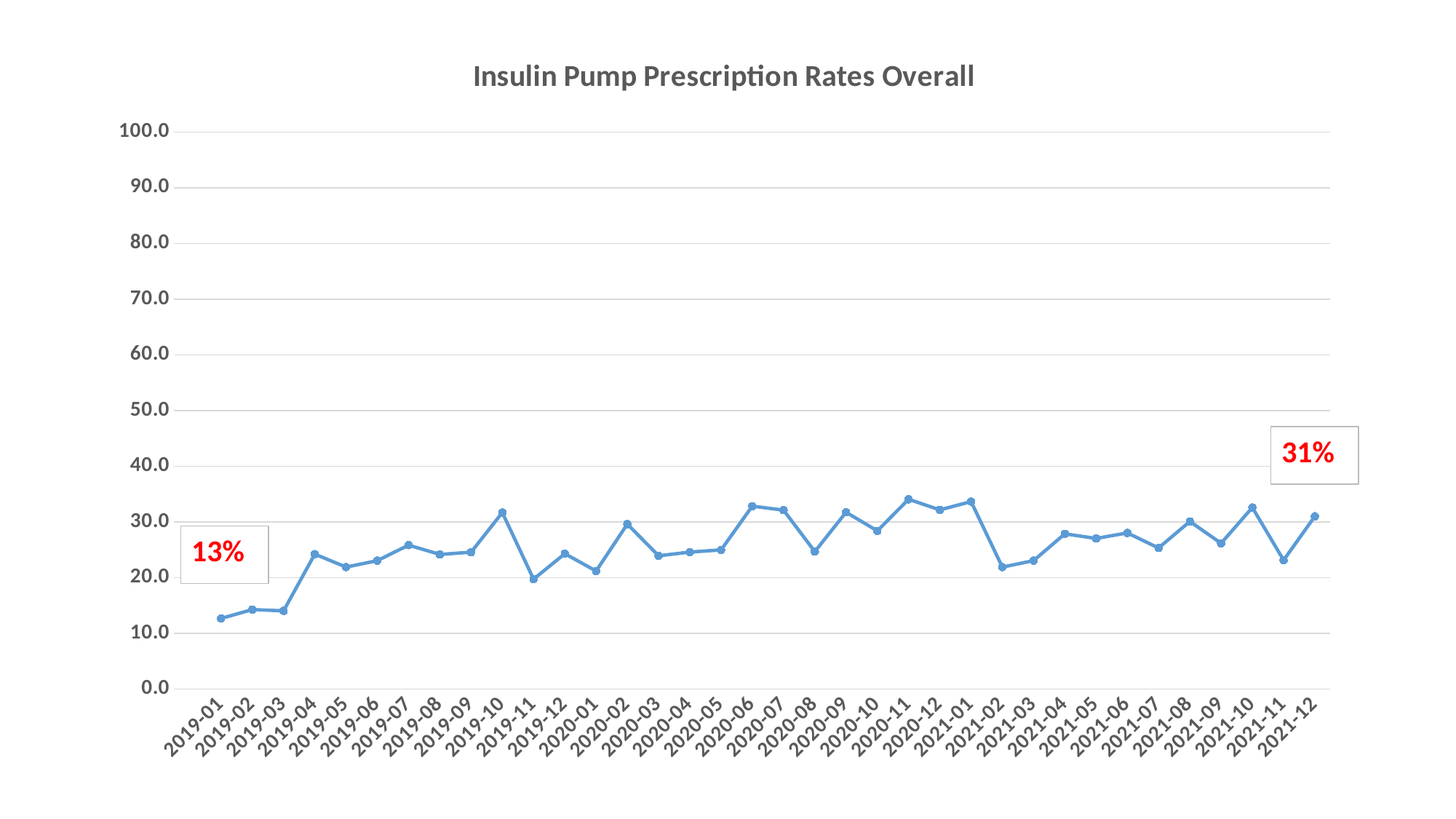
What percentage is shown in the red annotation near the end of the line? 31% How many monthly data points are plotted on the chart? 36 Is the value for 2019-01 greater or less than 20.0? less What is the title of the chart? Insulin Pump Prescription Rates Overall What kind of chart is shown on the slide? line chart Which is larger, the value for 2019-01 or the value for 2021-12? 2021-12 Is the value for 2020-11 greater or less than 30.0? greater Is the value for 2019-04 greater or less than 20.0? greater Which month has the lowest value on the chart? 2019-01 What percentage is shown in the red annotation near the start of the line? 13% Do the values generally rise or fall from 2019-01 to 2021-12? rise